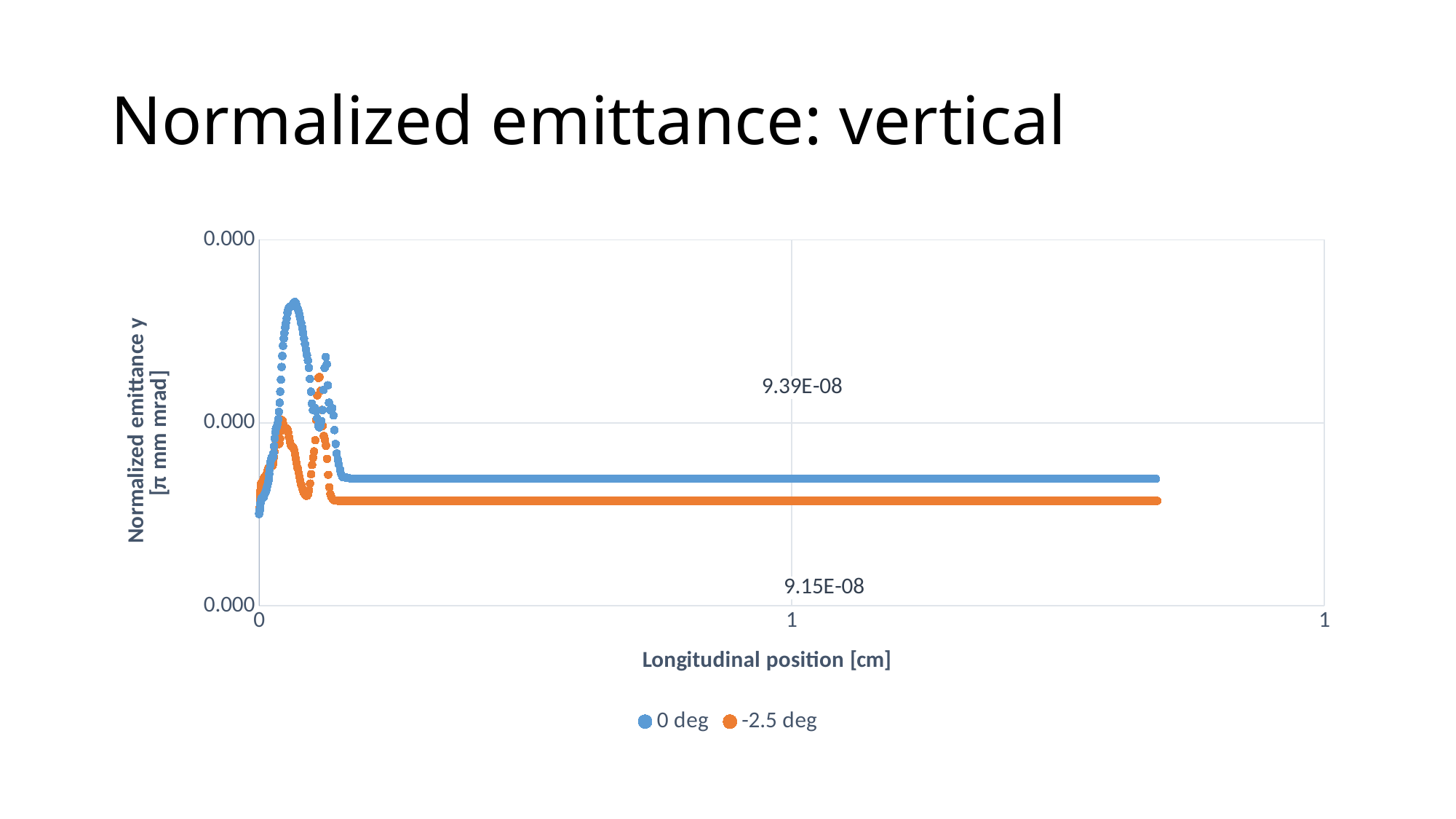
What is the smaller of the two data label values printed on the chart? 9.15E-08 What is the x-axis title of the chart? Longitudinal position [cm] How many series does the legend list? 2 What are the two series named in the legend? 0 deg and -2.5 deg What is the larger of the two data label values printed on the chart? 9.39E-08 What kind of chart is shown on the slide? Scatter chart What is the y-axis title of the chart? Normalized emittance y [π mm mrad] Which series reaches the highest peak value on the chart? 0 deg Which series has the higher flat (plateau) value at large longitudinal positions, 0 deg or -2.5 deg? 0 deg After the initial peaks near the left of the chart, do the values of both series rise, fall, or stay flat along the x axis? Stay flat What is the title of the slide? Normalized emittance: vertical Which colour represents the -2.5 deg series? Orange